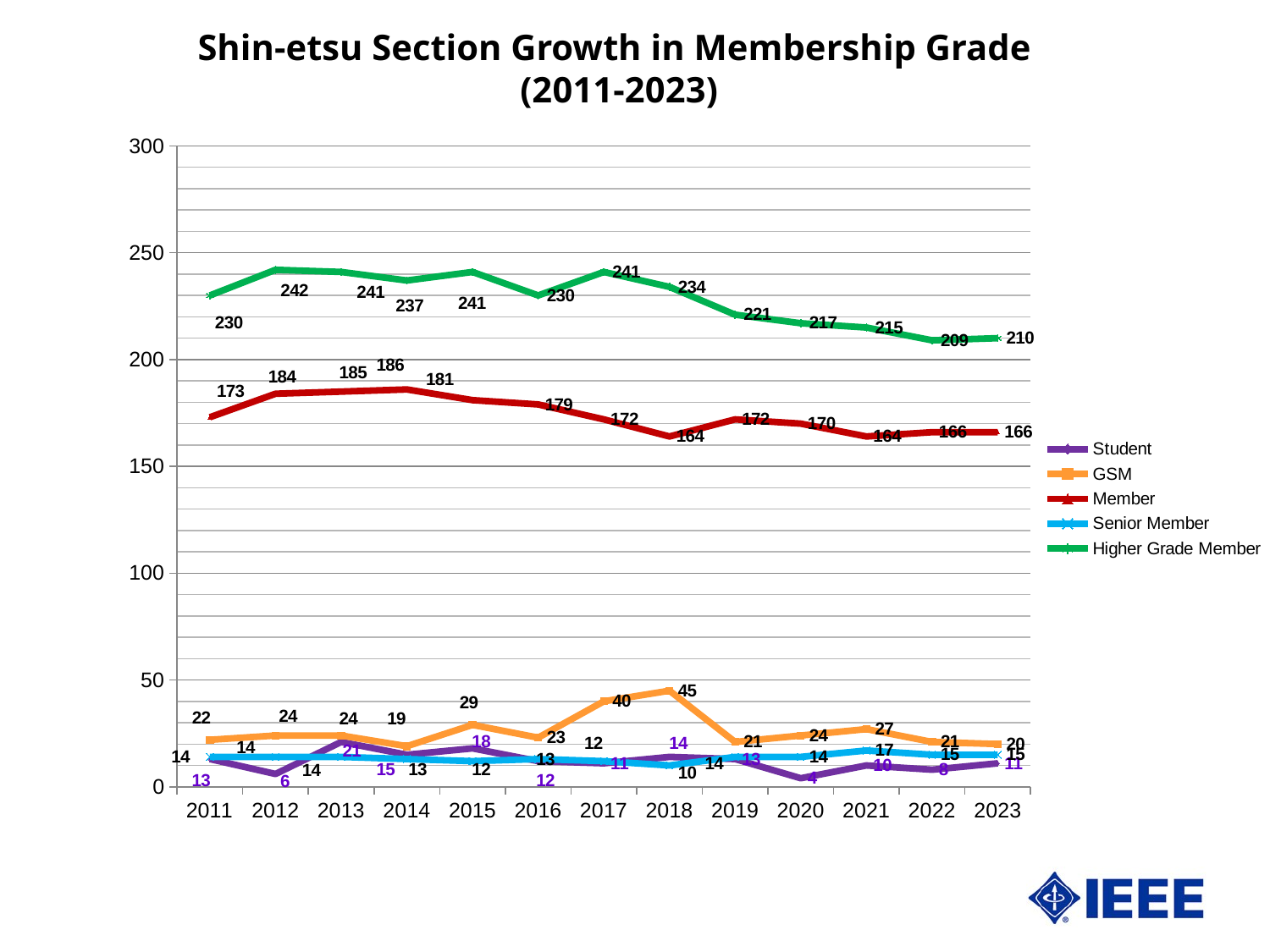
Which year has the larger GSM value, 2017 or 2018? 2018 What is the Higher Grade Member value in 2012? 242 Is the Member value in 2013 greater or less than 150? greater Does the Higher Grade Member line rise or fall from 2017 to 2022? fall In which year is the Higher Grade Member value lowest? 2022 In which year is the Higher Grade Member value highest? 2012 How many series does the legend list? 5 What is the difference between the Higher Grade Member values in 2011 and 2023? 20 How many years are plotted along the x axis? 13 What is the GSM value in 2018? 45 What is the Member value in 2014? 186 What kind of chart is shown on the slide? line chart